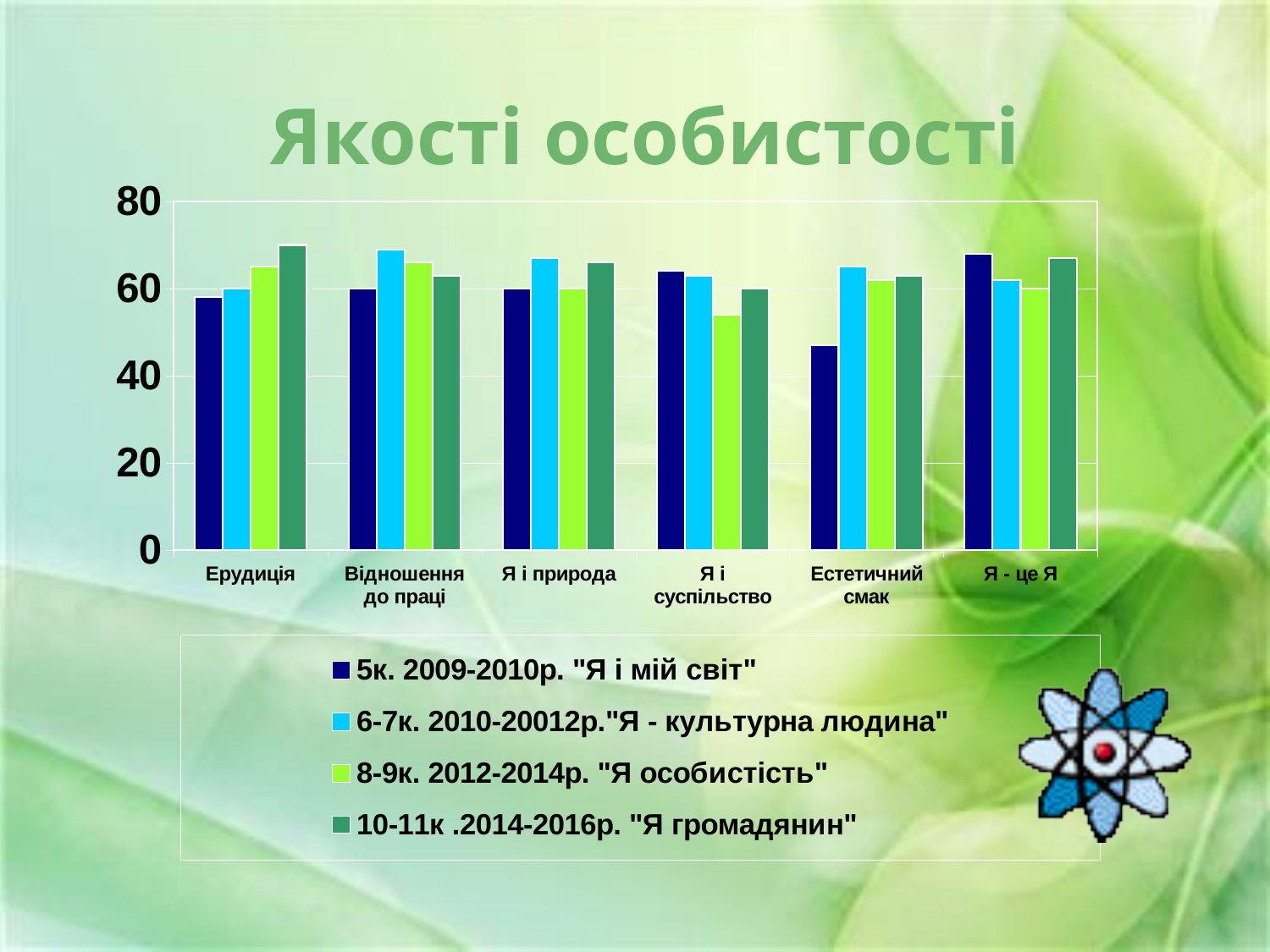
Is the value for Відношення до праці in the 6-7к. 2010-20012р."Я - культурна людина" series greater or less than 60? greater Is the value for Я і суспільство in the 8-9к. 2012-2014р. "Я особистість" series greater or less than 60? less Which category has the highest value in the 5к. 2009-2010р. "Я і мій світ" series? Я - це Я Is the value for Естетичний смак in the 5к. 2009-2010р. "Я і мій світ" series greater or less than 60? less What kind of chart is shown on the slide? bar chart Which category has the lowest value in the 5к. 2009-2010р. "Я і мій світ" series? Естетичний смак How many series does the legend list? 4 How many categories are shown on the x axis of the chart? 6 For Естетичний смак, which is larger: the 5к. 2009-2010р. "Я і мій світ" value or the 6-7к. 2010-20012р."Я - культурна людина" value? 6-7к. 2010-20012р."Я - культурна людина" What is the title of the chart? Якості особистості Which series does the dark blue bar represent according to the legend? 5к. 2009-2010р. "Я і мій світ"